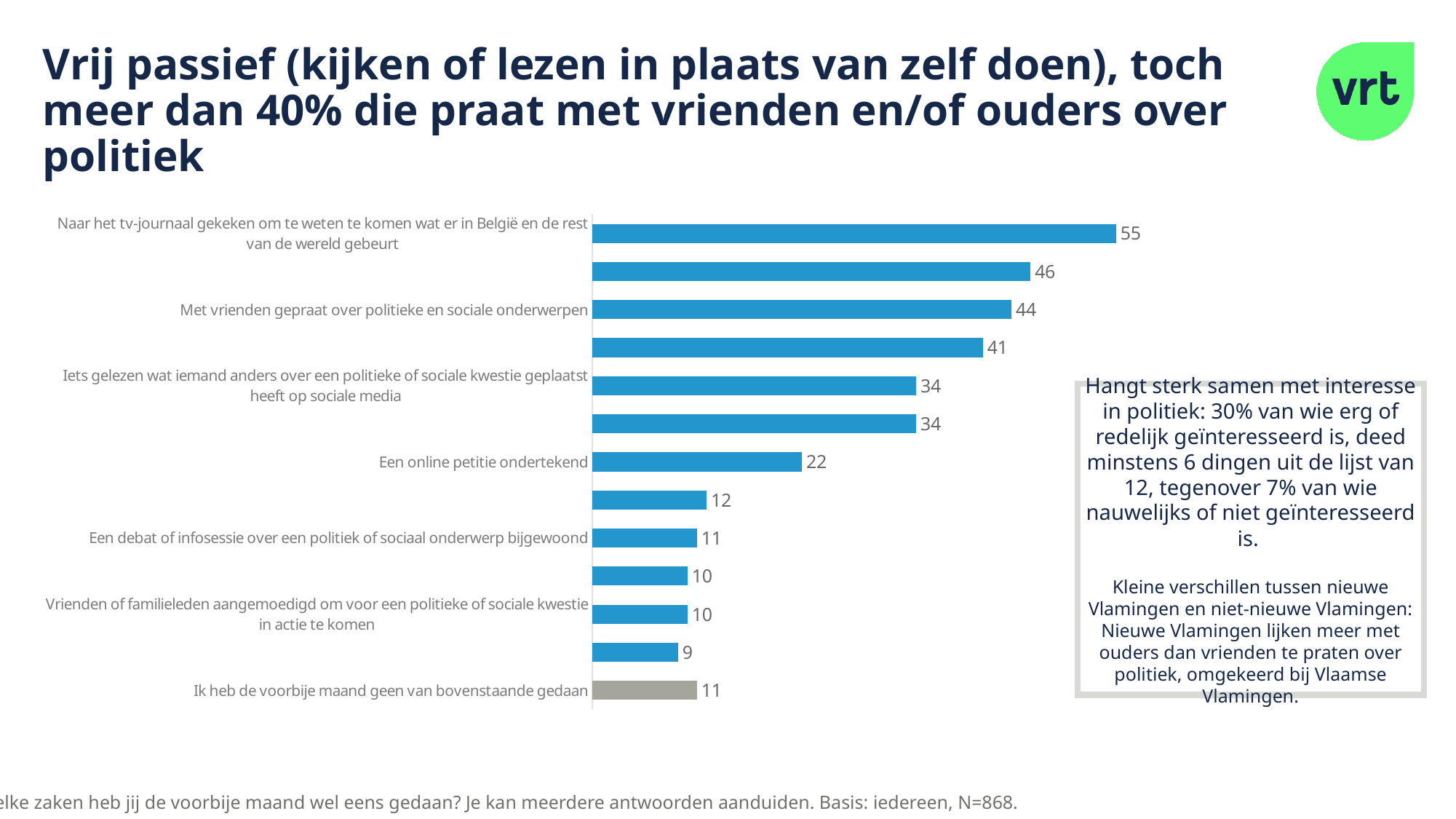
What is the difference between the value for "Naar het tv-journaal gekeken..." and the value for "Met vrienden gepraat over politieke en sociale onderwerpen"? 11 What value is shown for "Naar het tv-journaal gekeken om te weten te komen wat er in België en de rest van de wereld gebeurt"? 55 How many bars are plotted in the chart? 13 What value is shown for "Een online petitie ondertekend"? 22 Which is larger: the value for "Een online petitie ondertekend" or the value for "Een debat of infosessie over een politiek of sociaal onderwerp bijgewoond"? Een online petitie ondertekend Which category has the highest value in the chart? Naar het tv-journaal gekeken om te weten te komen wat er in België en de rest van de wereld gebeurt What is the smallest value shown on any bar in the chart? 9 What value is shown for "Ik heb de voorbije maand geen van bovenstaande gedaan"? 11 What kind of chart is shown on the slide? Bar chart What value is shown for "Een debat of infosessie over een politiek of sociaal onderwerp bijgewoond"? 11 What value is shown for "Met vrienden gepraat over politieke en sociale onderwerpen"? 44 What colour is the bar for "Ik heb de voorbije maand geen van bovenstaande gedaan"? Grey